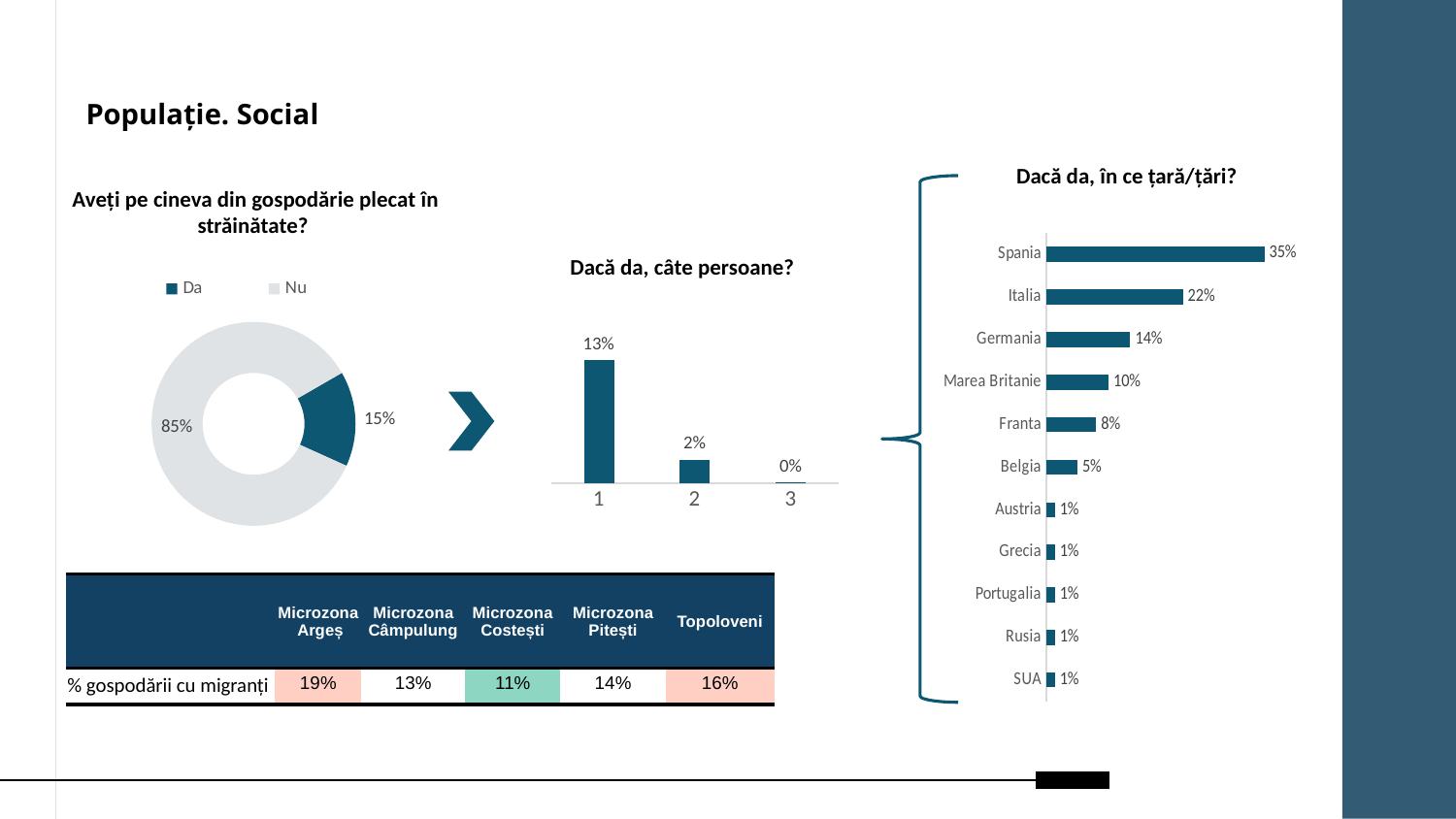
In the 'Dacă da, câte persoane?' chart, do the values rise or fall from category 1 to category 3? Fall In the 'Dacă da, în ce țară/țări?' chart, how many countries are listed? 11 In the 'Dacă da, câte persoane?' chart, how many categories are shown on the x axis? 3 In the 'Dacă da, în ce țară/țări?' chart, what is the difference between Spania and Italia? 13% In the 'Dacă da, în ce țară/țări?' chart, what is the value for Germania? 14% In the 'Dacă da, în ce țară/țări?' chart, which is larger, Franta or Belgia? Franta In the 'Dacă da, câte persoane?' chart, what is the value for category 1? 13% In the 'Aveți pe cineva din gospodărie plecat în străinătate?' chart, what percentage answered 'Nu'? 85% What kind of chart is the 'Aveți pe cineva din gospodărie plecat în străinătate?' chart? Doughnut chart In the 'Dacă da, în ce țară/țări?' chart, which country has the highest value? Spania In the 'Aveți pe cineva din gospodărie plecat în străinătate?' chart, what percentage answered 'Da'? 15% In the 'Dacă da, câte persoane?' chart, what is the value for category 2? 2%